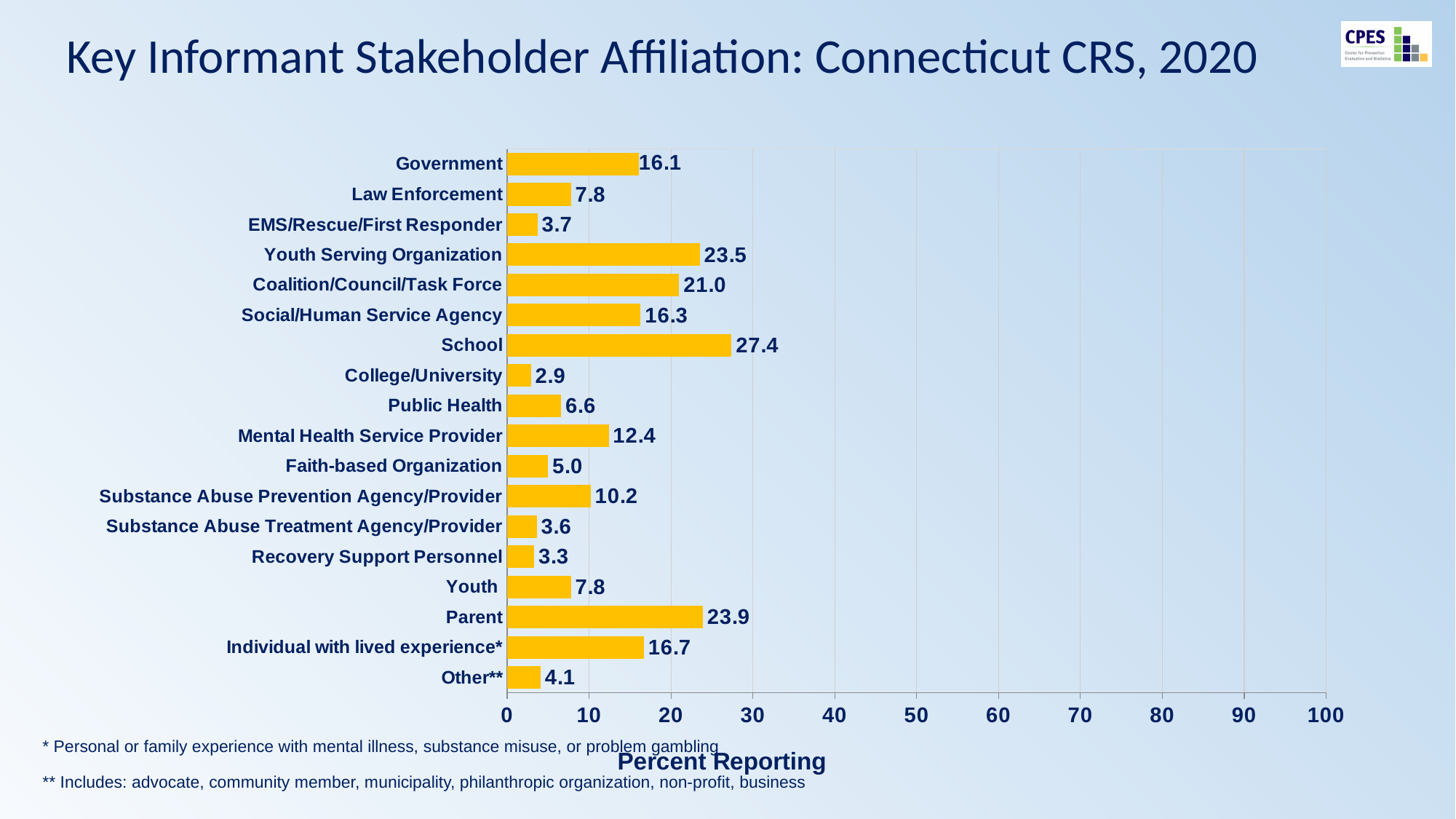
What is the value for Individual with lived experience*? 16.7 Which category has the lowest value? College/University Is the value for Substance Abuse Prevention Agency/Provider greater or less than 20? less What is the difference between the values for Government and Law Enforcement? 8.3 Which category has the highest value? School What kind of chart is shown on the slide? bar chart What is the value for Mental Health Service Provider? 12.4 What is the label of the horizontal axis? Percent Reporting What is the difference between the values for Parent and Youth Serving Organization? 0.4 How many categories are shown in the chart? 18 What is the value for School? 27.4 Which is larger, the value for Coalition/Council/Task Force or the value for Social/Human Service Agency? Coalition/Council/Task Force